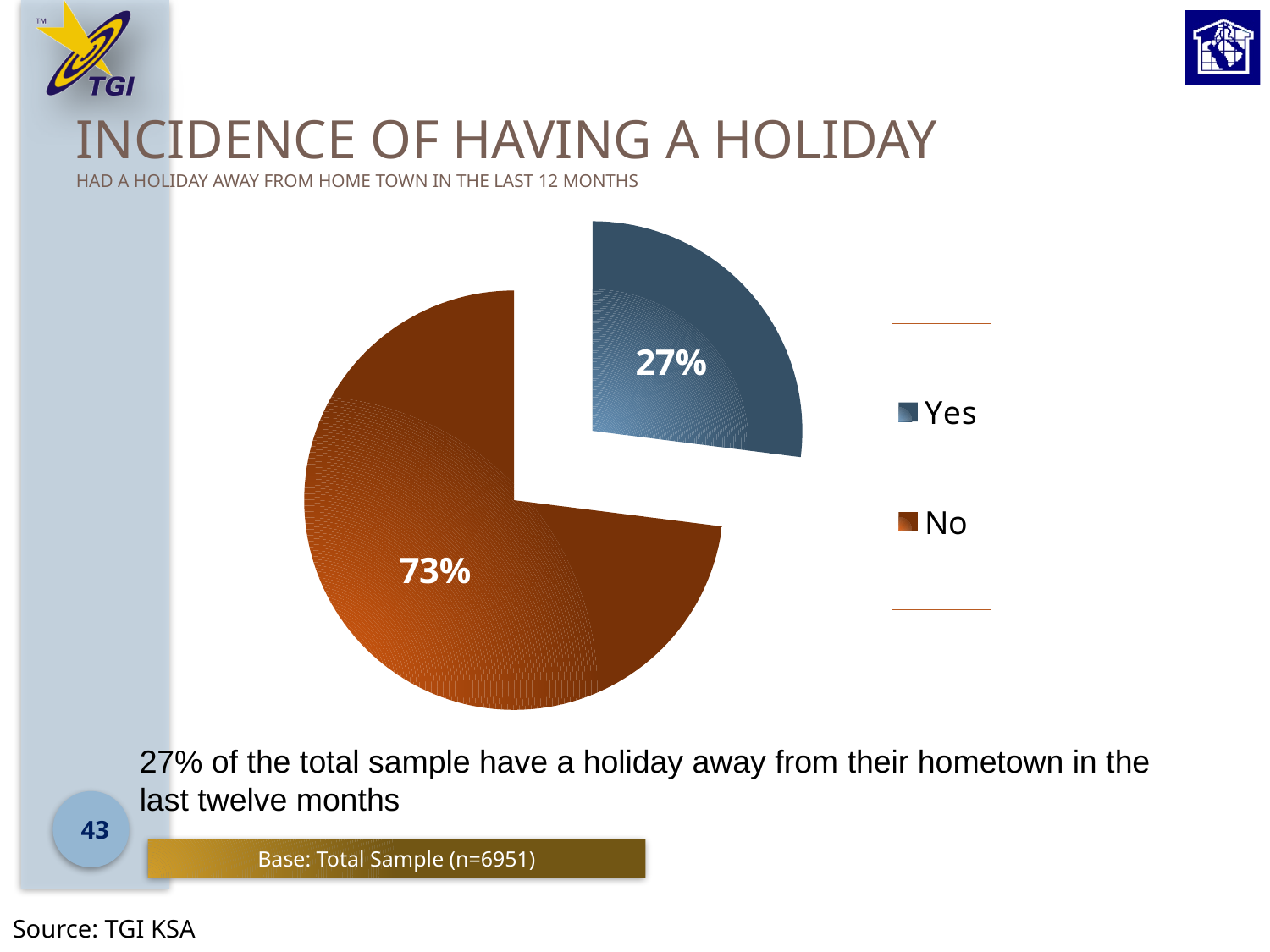
What is the title of the slide containing the chart? INCIDENCE OF HAVING A HOLIDAY What is the base sample size stated below the chart? n=6951 What share of the pie does the Yes slice represent? 27% How many entries does the legend list? 2 What is the difference in percentage points between the No and Yes slices? 46 Which category has the smallest share of the pie? Yes How many slices does the pie chart have? 2 Which category has the largest share of the pie? No What kind of chart is shown on the slide? pie chart What percentage of respondents answered Yes to having had a holiday away from home town in the last 12 months? 27% Which slice is larger, Yes or No? No What percentage of respondents answered No? 73%